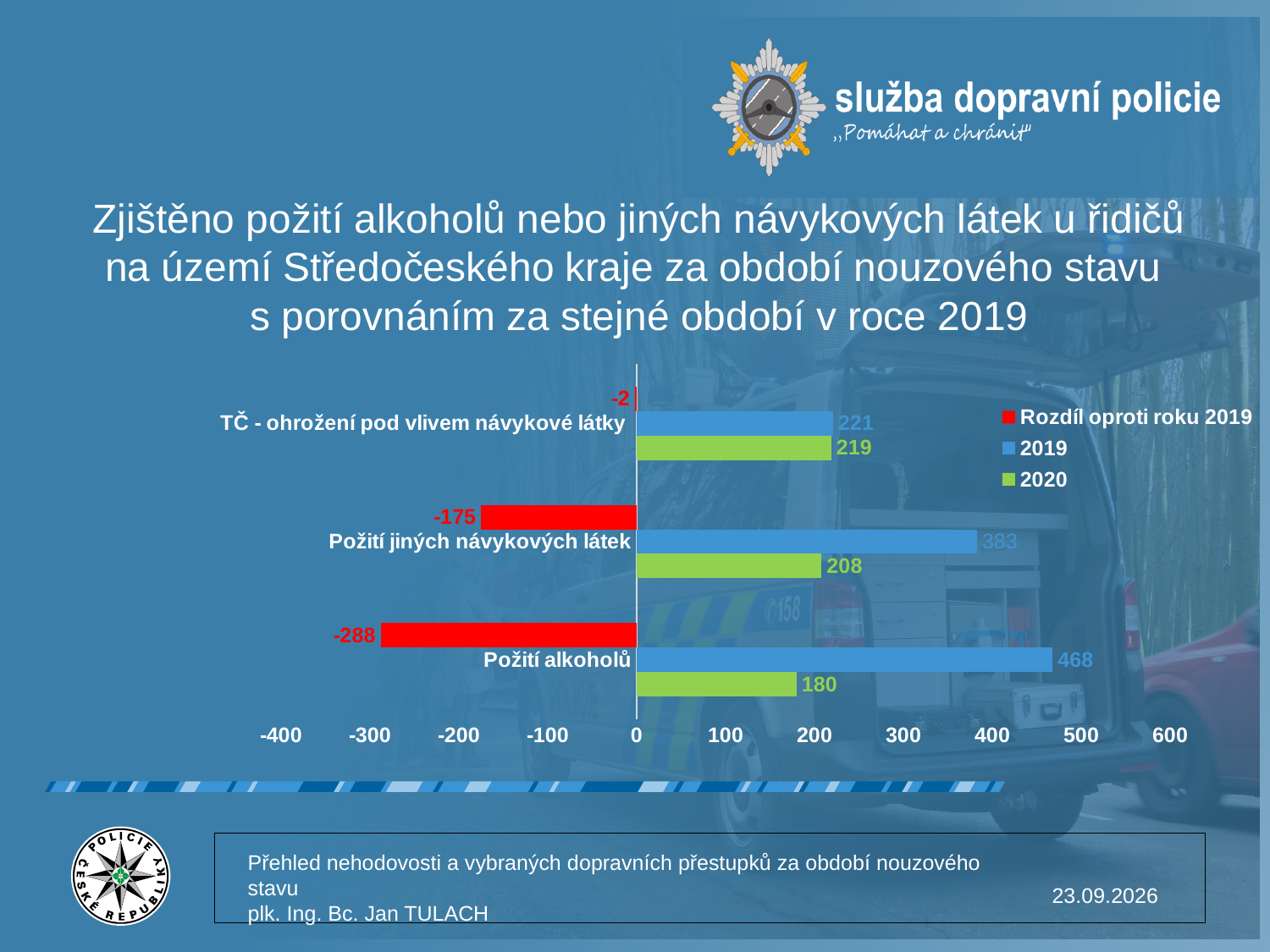
Which category has the lowest 2020 value? Požití alkoholů What kind of chart is shown on the slide? bar chart Is the 2019 value for Požití jiných návykových látek greater or less than 300? greater Which category has the highest 2019 value? Požití alkoholů What is the difference between the 2019 and 2020 values for Požití jiných návykových látek? 175 What is the Rozdíl oproti roku 2019 value for TČ - ohrožení pod vlivem návykové látky? -2 How many categories are shown on the chart? 3 Which is larger for Požití alkoholů, the 2019 value or the 2020 value? 2019 How many series does the legend list? 3 What is the 2020 value for Požití jiných návykových látek? 208 What is the 2020 value for TČ - ohrožení pod vlivem návykové látky? 219 What is the 2019 value for Požití alkoholů? 468